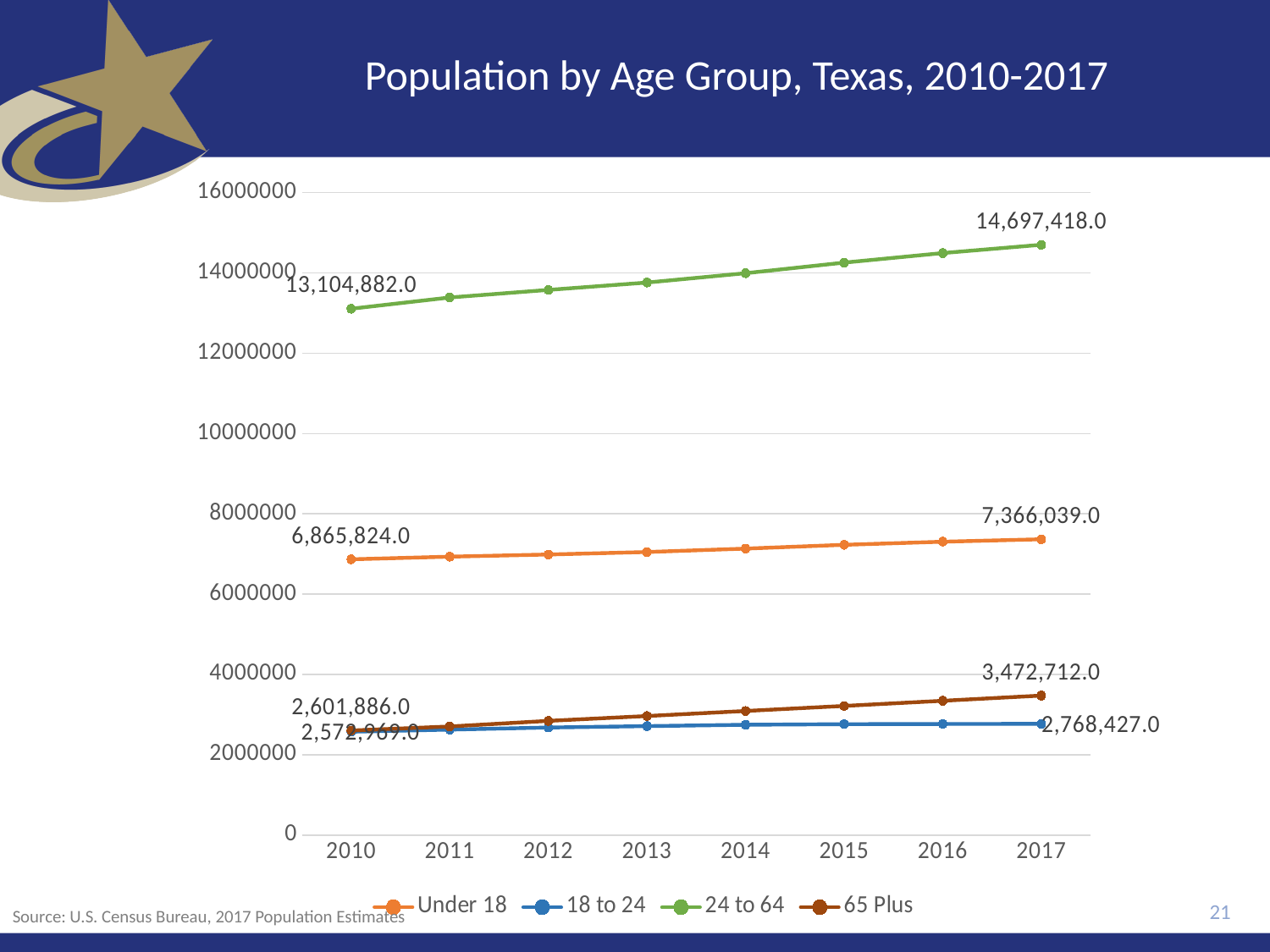
Which age group has the highest population in 2017? 24 to 64 Which age group has the lowest population in 2017? 18 to 24 What kind of chart is shown on the slide? line chart Is the value for Under 18 in 2014 greater or less than 8000000? less What is the value for the 24 to 64 series in 2010? 13,104,882.0 What is the value for the 24 to 64 series in 2017? 14,697,418.0 What is the value for the Under 18 series in 2017? 7,366,039.0 What is the value for the 65 Plus series in 2017? 3,472,712.0 How many series does the legend list? 4 What is the value for the 18 to 24 series in 2017? 2,768,427.0 By how much did the Under 18 population grow from 2010 to 2017? 500,215.0 By how much did the 24 to 64 population grow from 2010 to 2017? 1,592,536.0